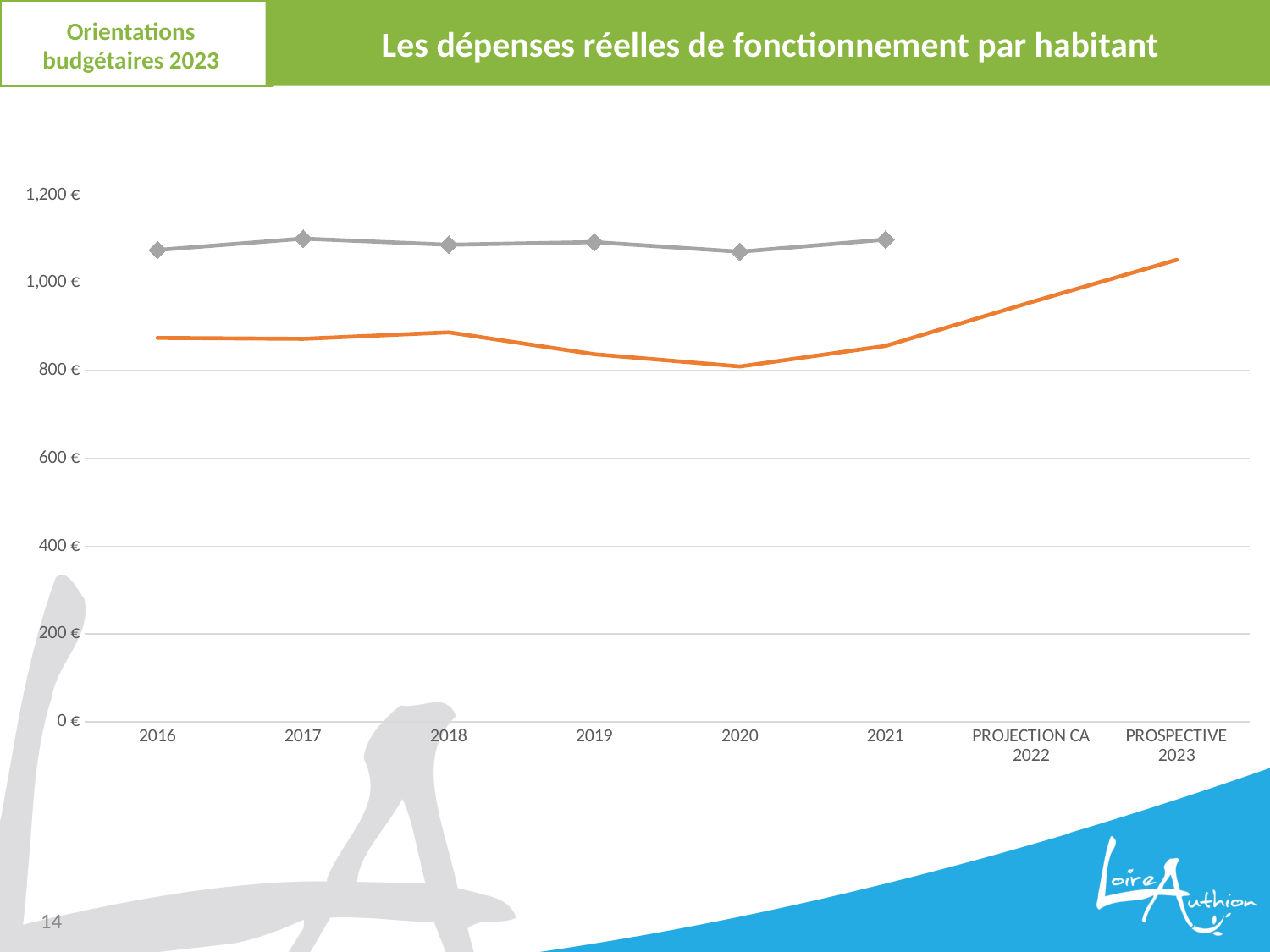
Which x-axis category has the lowest value on the orange line? 2020 Is the value of the grey line for 2021 greater or less than 1,200 €? less Is the value of the orange line for 2020 greater or less than 1,000 €? less Does the orange line rise or fall from 2020 to PROSPECTIVE 2023? rise Does the orange line rise or fall from 2018 to 2020? fall What is the title of the chart on the slide? Les dépenses réelles de fonctionnement par habitant Is the value of the orange line for PROSPECTIVE 2023 greater or less than 1,000 €? greater How many categories are shown along the x axis of the chart? 8 In 2019, which line has the larger value, the grey line or the orange line? the grey line Which x-axis category has the highest value on the orange line? PROSPECTIVE 2023 What kind of chart is shown on the slide? line chart